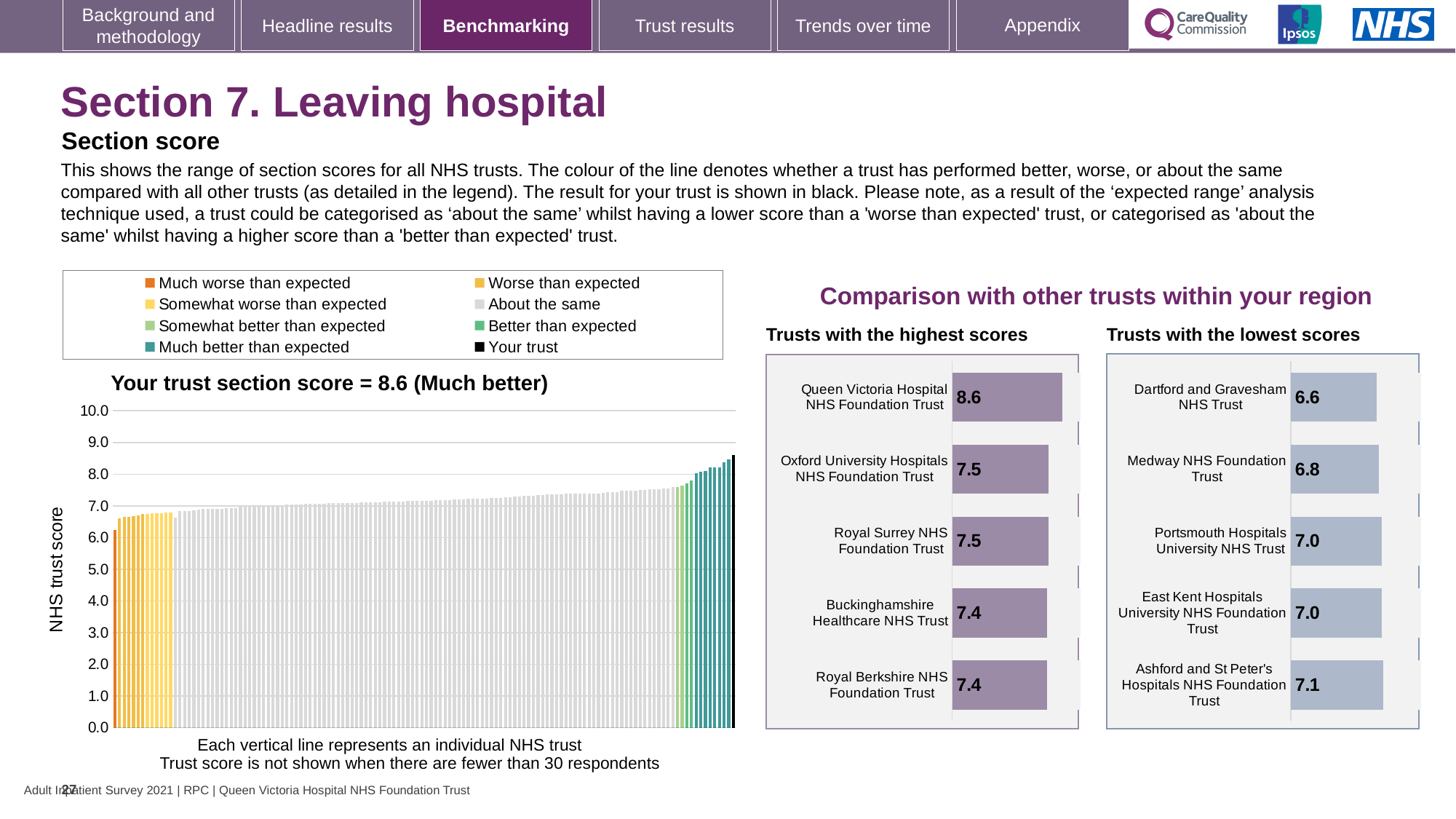
In the 'Trusts with the lowest scores' chart, what is the difference between the scores of Ashford and St Peter's Hospitals NHS Foundation Trust and Dartford and Gravesham NHS Trust? 0.5 What type of chart is the 'Your trust section score' chart on the left? Bar chart In the 'Trusts with the highest scores' chart, what is the score for Buckinghamshire Healthcare NHS Trust? 7.4 In the 'Trusts with the highest scores' chart, what is the difference between the scores of Queen Victoria Hospital NHS Foundation Trust and Royal Berkshire NHS Foundation Trust? 1.2 In the 'Trusts with the highest scores' chart, which trust has the highest score? Queen Victoria Hospital NHS Foundation Trust In the 'Trusts with the lowest scores' chart, what is the score for Medway NHS Foundation Trust? 6.8 In the 'Trusts with the lowest scores' chart, which has the higher score: Medway NHS Foundation Trust or Dartford and Gravesham NHS Trust? Medway NHS Foundation Trust In the 'Your trust section score' chart on the left, do the bars rise or fall from left to right? Rise In the 'Trusts with the highest scores' chart, what is the score for Queen Victoria Hospital NHS Foundation Trust? 8.6 How many trusts are listed in the 'Trusts with the highest scores' chart? 5 How many entries does the legend above the 'Your trust section score' chart list? 8 In the 'Trusts with the lowest scores' chart, which trust has the lowest score? Dartford and Gravesham NHS Trust